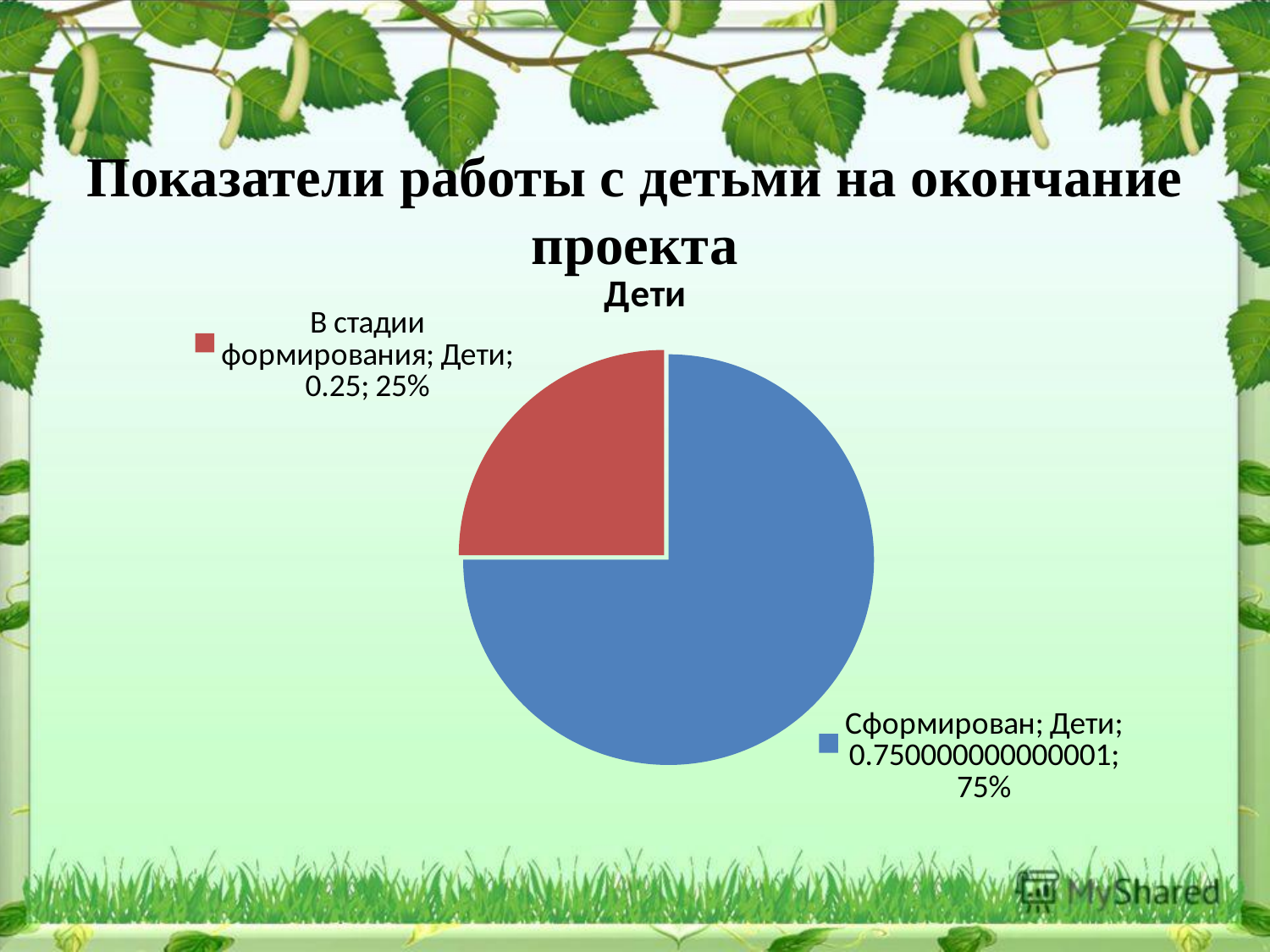
What value is printed for the 'В стадии формирования' slice? 0.25 Which is larger, the 'Сформирован' slice or the 'В стадии формирования' slice? Сформирован Which slice is the smallest? В стадии формирования What kind of chart is shown on the slide? pie chart How many slices does the pie chart have? 2 What colour is the 'Сформирован' slice? blue What is the title of the chart? Дети What percentage share does the 'В стадии формирования' slice have? 25% Which slice is the largest? Сформирован What percentage share does the 'Сформирован' slice have? 75% What is the difference in percentage points between the 'Сформирован' and 'В стадии формирования' slices? 50%